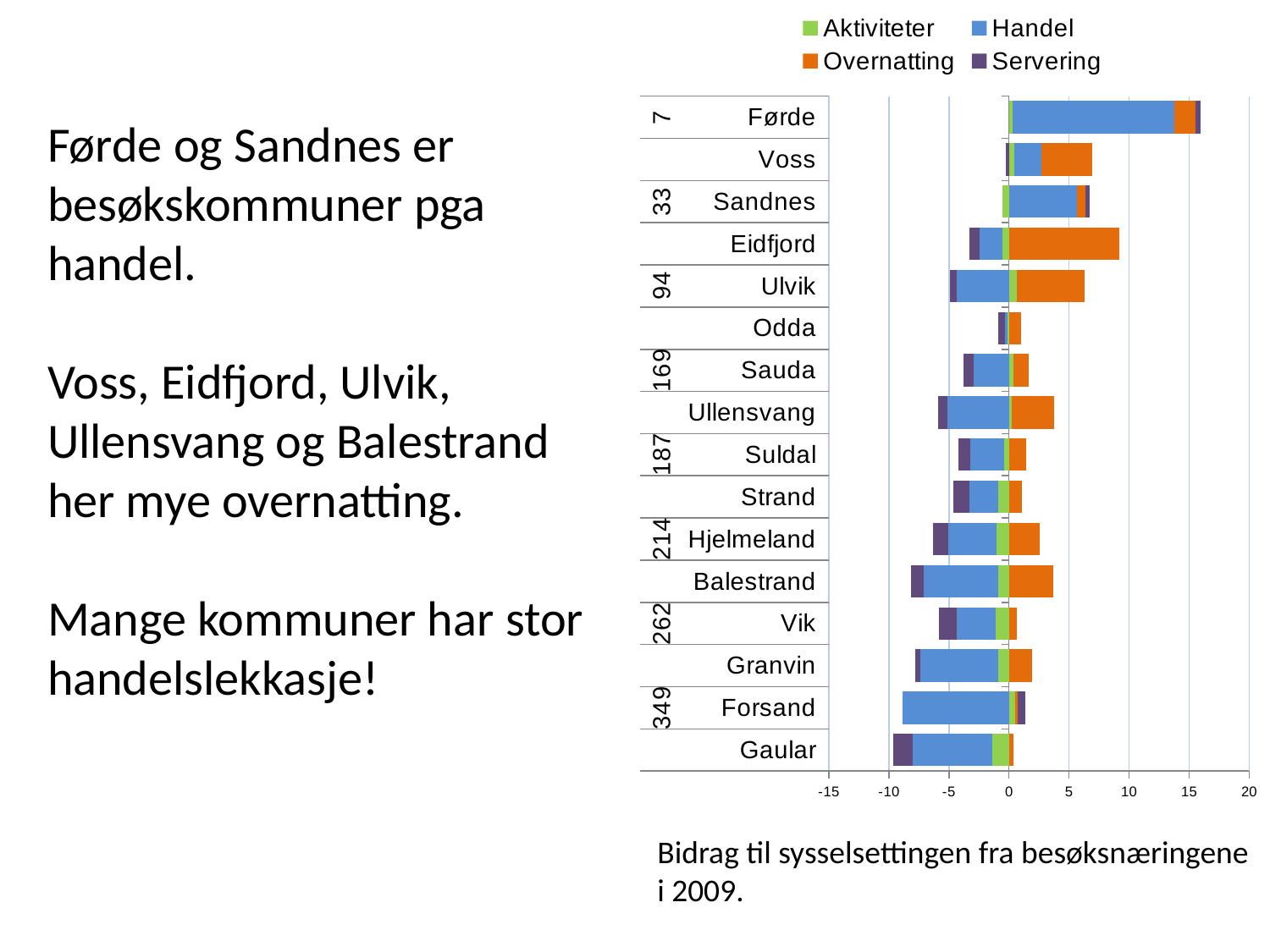
Which municipality has the largest Overnatting (orange) segment? Eidfjord Whose Handel bar extends further to the left (more negative), Forsand or Gaular? Forsand Is the Handel value for Førde greater or less than 10? greater Which municipality is listed at the bottom of the chart? Gaular Is the Overnatting value for Eidfjord greater or less than 5? greater Which colour represents Handel in the legend? blue How many municipalities (categories) are plotted on the chart? 16 Which municipality has the largest Handel (blue) segment? Førde Is the Handel value for Forsand greater or less than -5? less What kind of chart is shown on the slide? bar chart Which has the larger Handel value, Førde or Sandnes? Førde How many series does the chart legend list? 4